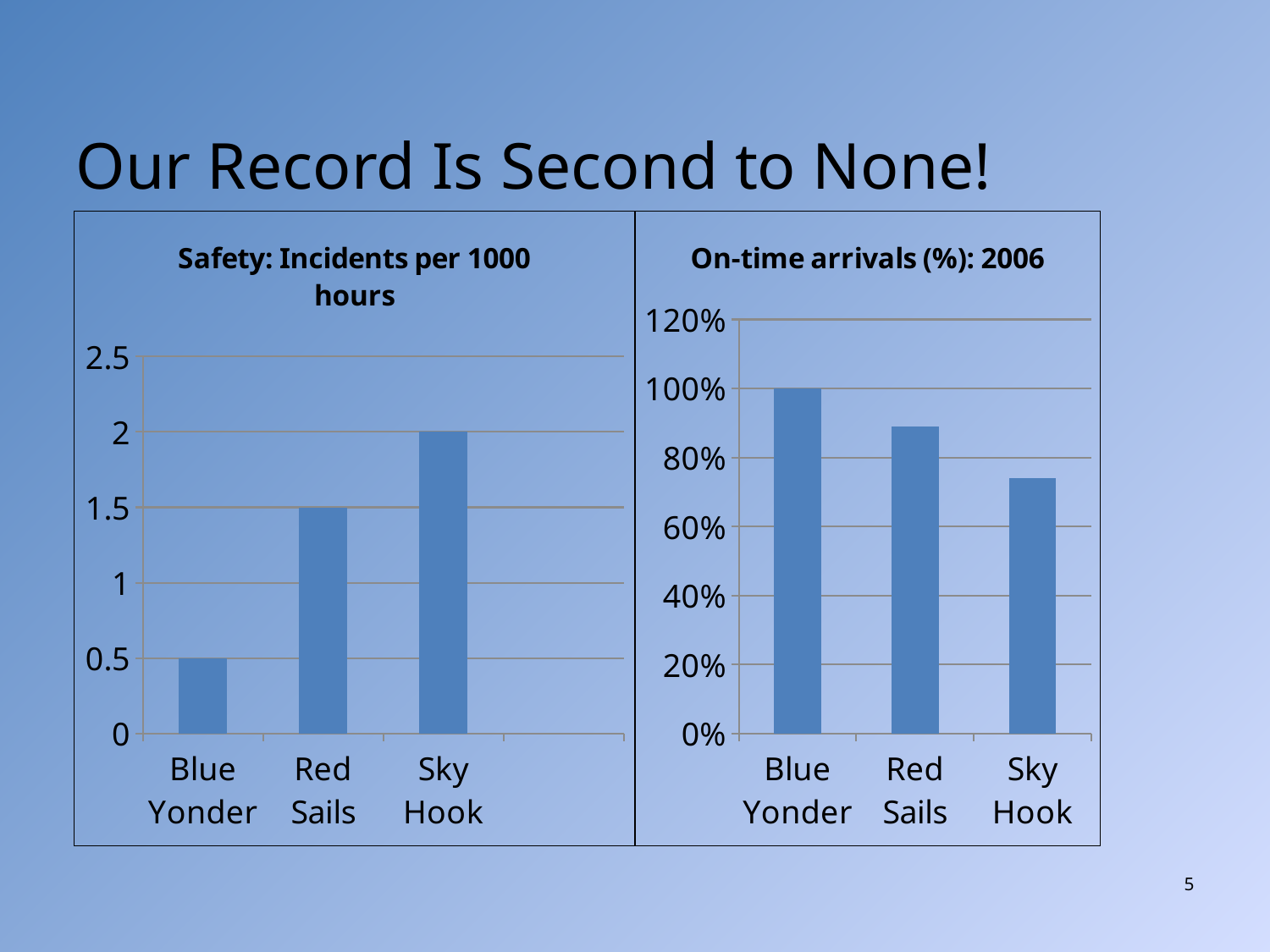
In the 'Safety: Incidents per 1000 hours' chart, which company has the lowest value? Blue Yonder In the 'On-time arrivals (%): 2006' chart, is the value for Sky Hook greater or less than 80%? less In the 'On-time arrivals (%): 2006' chart, is the value for Red Sails greater or less than 80%? greater In the 'Safety: Incidents per 1000 hours' chart, what is the value for Blue Yonder? 0.5 In the 'Safety: Incidents per 1000 hours' chart, what is the difference between the values for Sky Hook and Blue Yonder? 1.5 In the 'Safety: Incidents per 1000 hours' chart, do the values rise or fall from left to right? rise In the 'Safety: Incidents per 1000 hours' chart, what is the value for Sky Hook? 2 How many companies are shown in the 'On-time arrivals (%): 2006' chart? 3 What kind of chart is the 'Safety: Incidents per 1000 hours' chart? bar chart In the 'On-time arrivals (%): 2006' chart, which company has the lowest value? Sky Hook In the 'On-time arrivals (%): 2006' chart, what is the value for Blue Yonder? 100% In the 'Safety: Incidents per 1000 hours' chart, which company has the highest value? Sky Hook